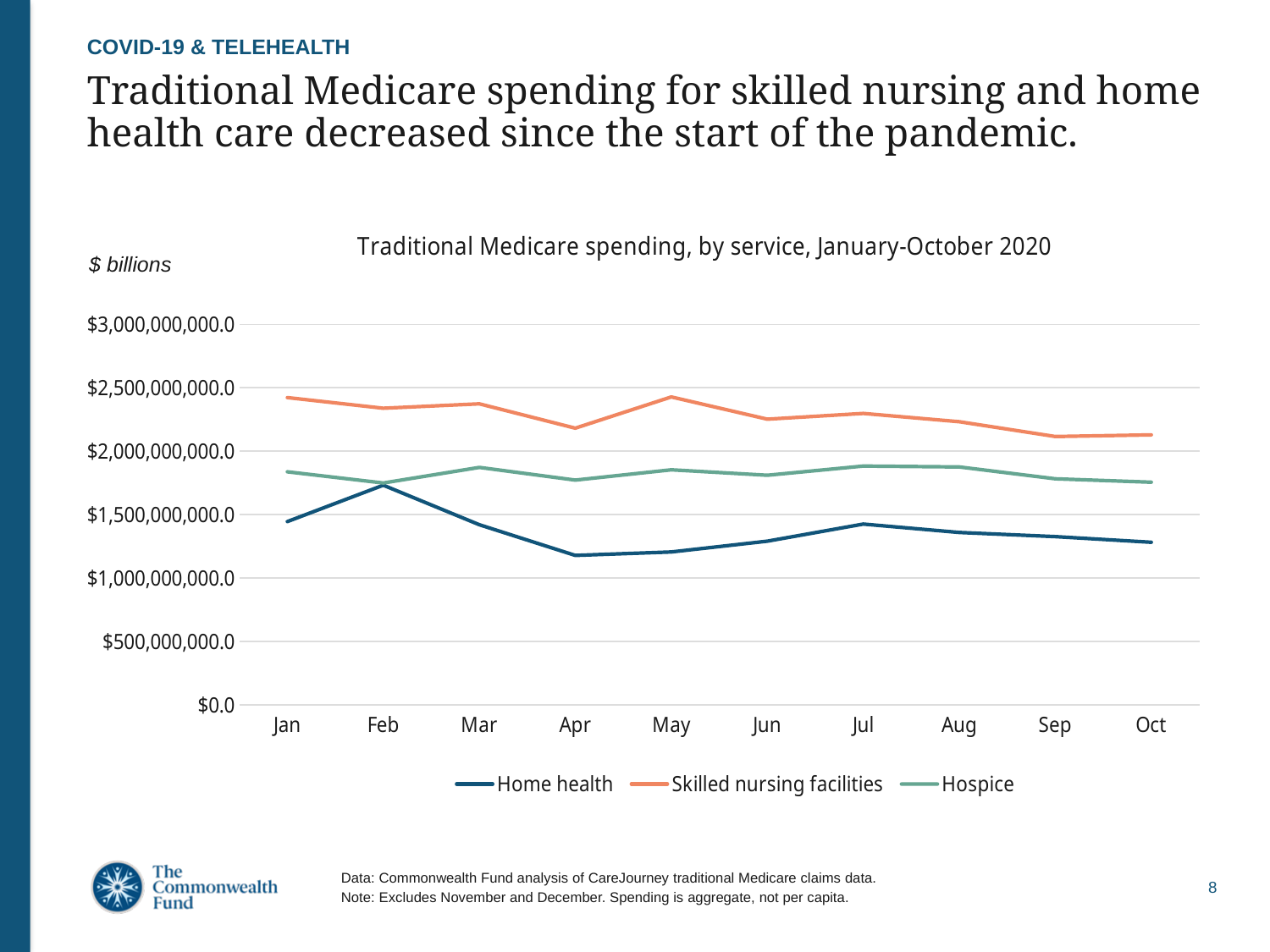
Which month has the highest Home health spending? Feb Is the value for Home health in Feb greater or less than $1,500,000,000.0? greater How many series does the legend list? 3 Is the value for Skilled nursing facilities in Jan greater or less than $2,000,000,000.0? greater What is the title of the chart? Traditional Medicare spending, by service, January-October 2020 What kind of chart is shown on the slide? Line chart For Skilled nursing facilities, which is larger: the value in Apr or the value in May? May How many months are plotted along the x axis? 10 In Jan, which is larger: Skilled nursing facilities or Hospice spending? Skilled nursing facilities Does Home health spending rise or fall from Feb to Apr? Fall Is the value for Home health in Apr greater or less than $1,500,000,000.0? less